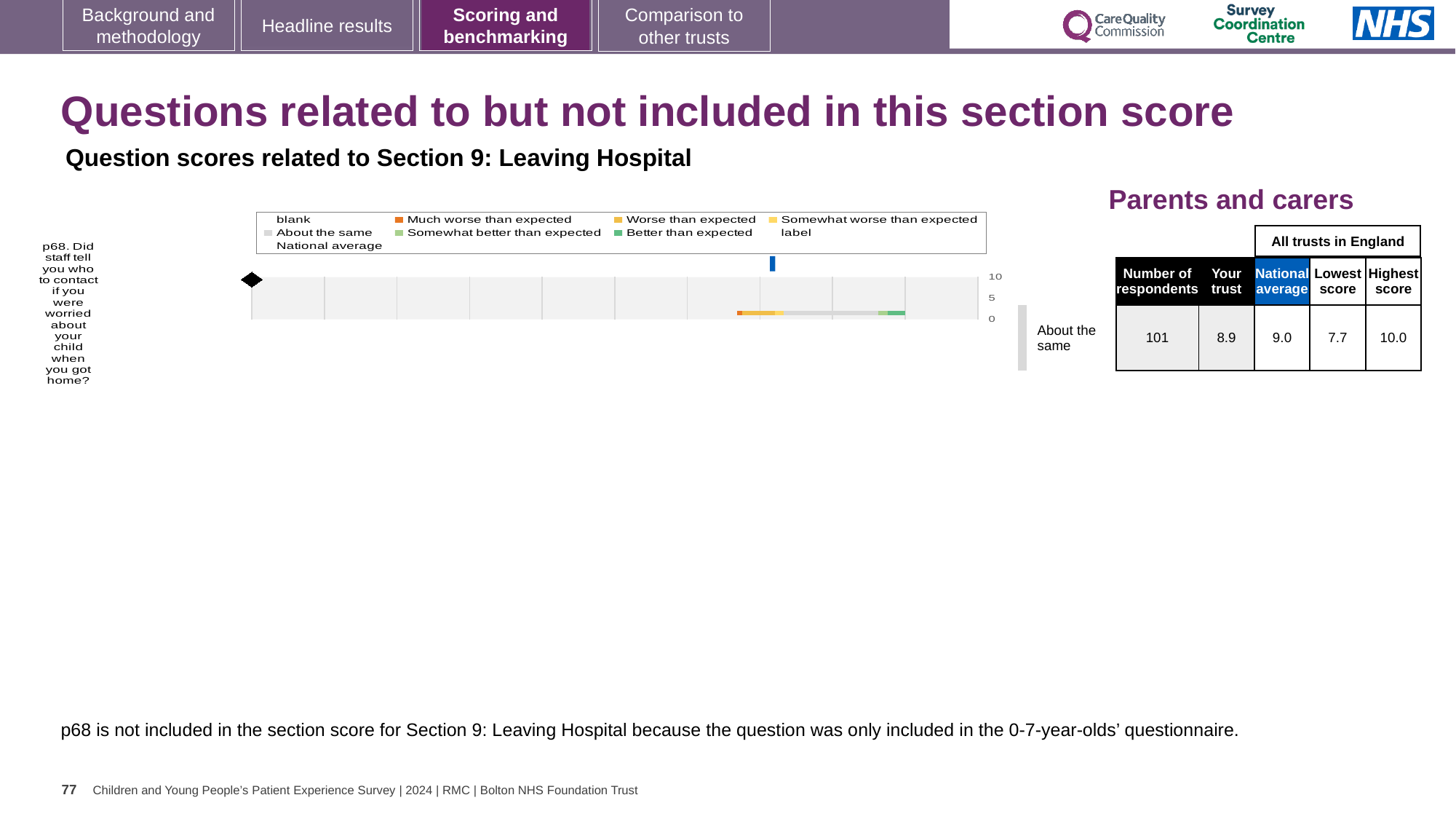
What kind of chart is shown on the slide? bar chart What is the national average score for p68? 9.0 How many respondents answered p68? 101 What is the lowest score among all trusts in England for p68? 7.7 How many entries does the chart legend list? 9 Which is larger for p68, the 'Your trust' score or the national average? national average Which question number is plotted in the chart? p68 What is the 'Your trust' score for p68? 8.9 What colour does the legend use for 'Much worse than expected'? orange How many questions (categories) are plotted in the chart? 1 What is the difference between the highest score and the lowest score for p68? 2.3 What is the highest score among all trusts in England for p68? 10.0